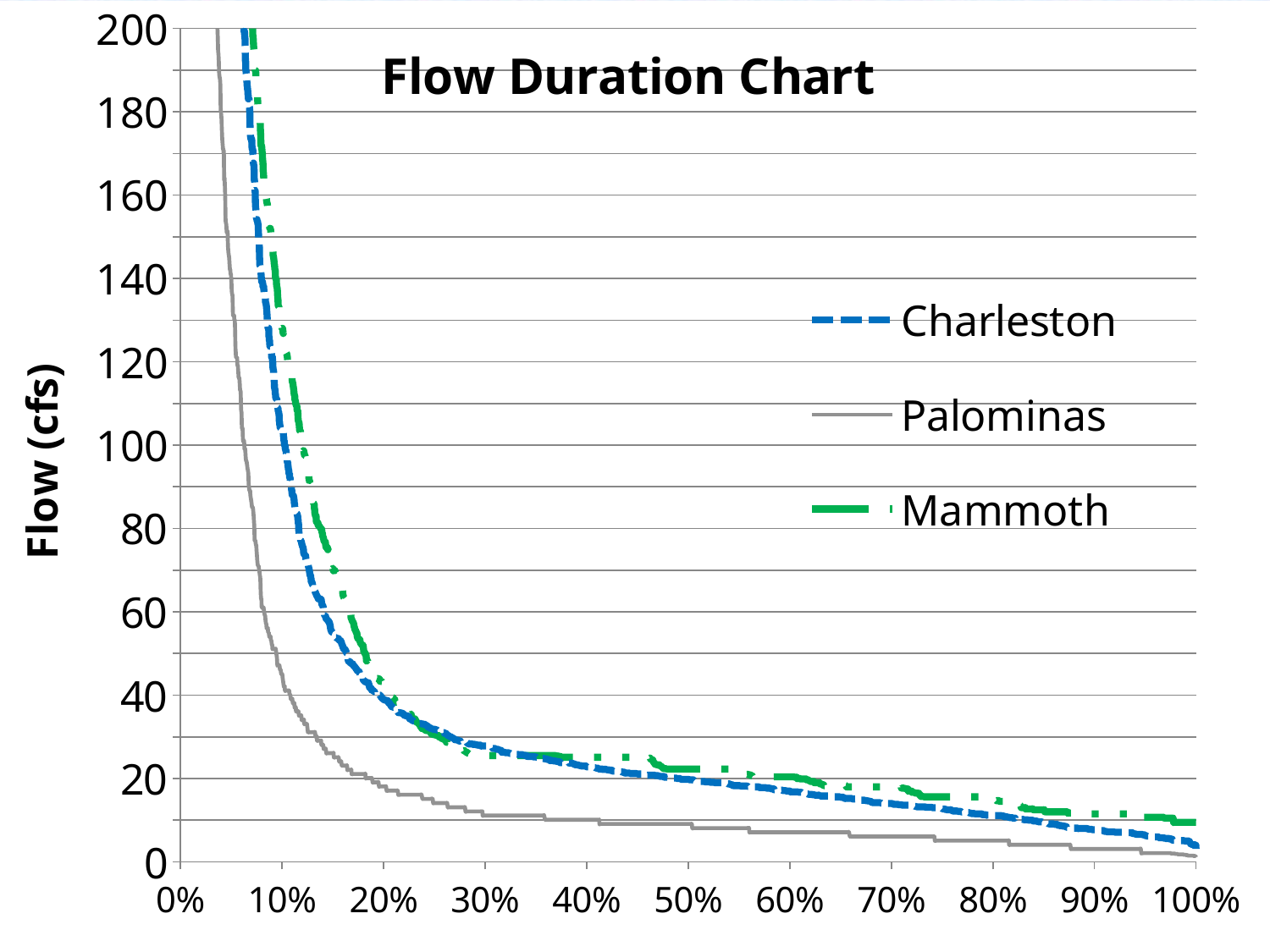
Is the value for Palominas at 10% greater or less than 60? less What is the title of the chart? Flow Duration Chart What kind of chart is the Flow Duration Chart? line chart Do the flow values rise or fall as the percentage on the x axis increases? fall Is the value for Charleston at 10% greater or less than 80? greater Which series has the lowest flow at 50%? Palominas How many series does the legend of the Flow Duration Chart list? 3 Is the value for Palominas at 50% greater or less than 20? less At 50%, which series has the larger flow, Palominas or Mammoth? Mammoth What is the label on the vertical axis? Flow (cfs)